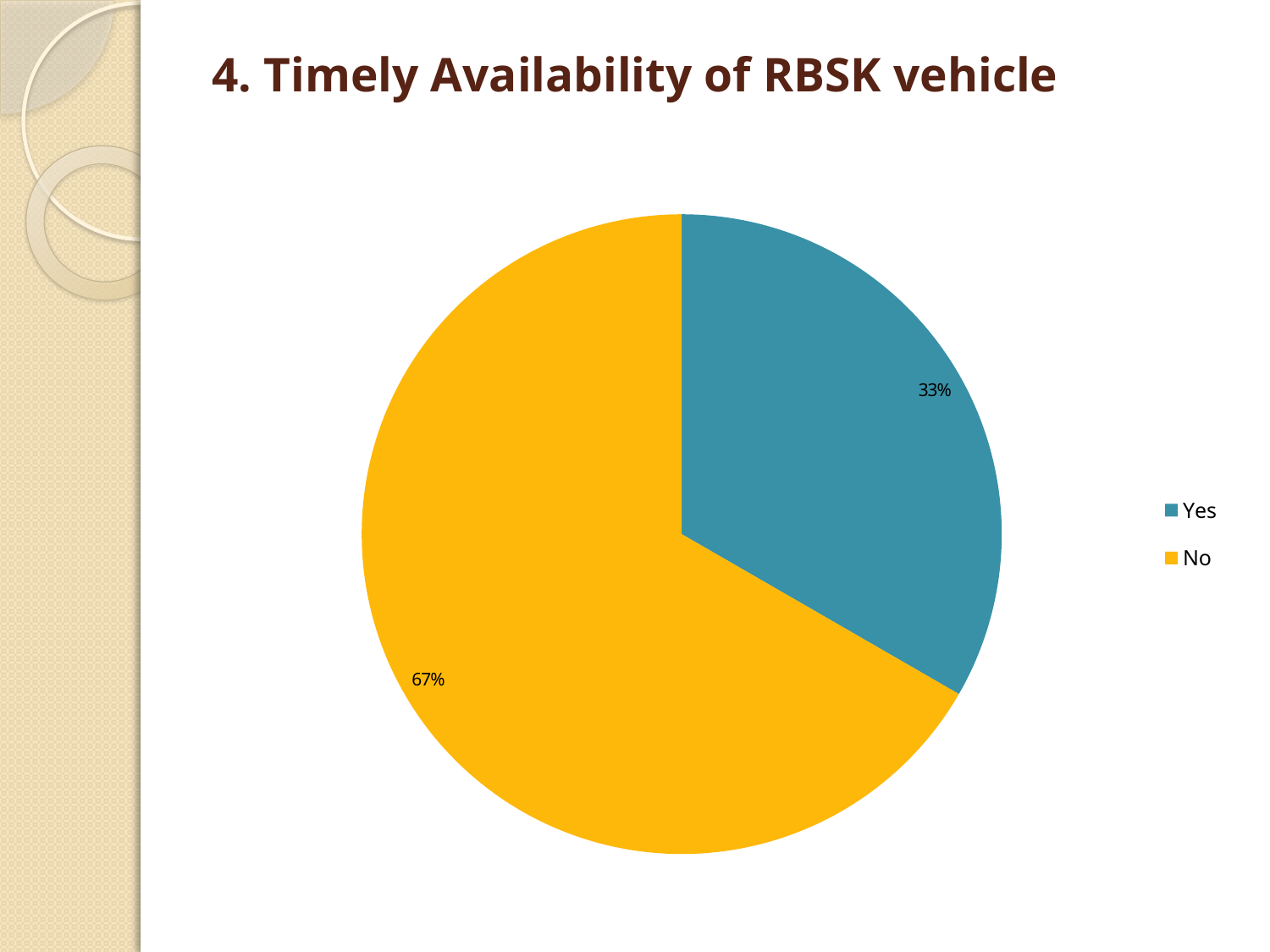
Which category has the largest slice of the pie? No Which is larger, the "Yes" slice or the "No" slice? No What share of the pie does the "Yes" slice represent? 33% How many entries does the legend list? 2 What share of the pie does the "No" slice represent? 67% Which category has the smallest slice of the pie? Yes How many slices does the pie chart have? 2 What colour is the "No" slice in the pie chart? yellow What is the difference in percentage points between the "No" and "Yes" slices? 34 What is the title of the slide containing the chart? 4. Timely Availability of RBSK vehicle What kind of chart is shown on the slide? pie chart